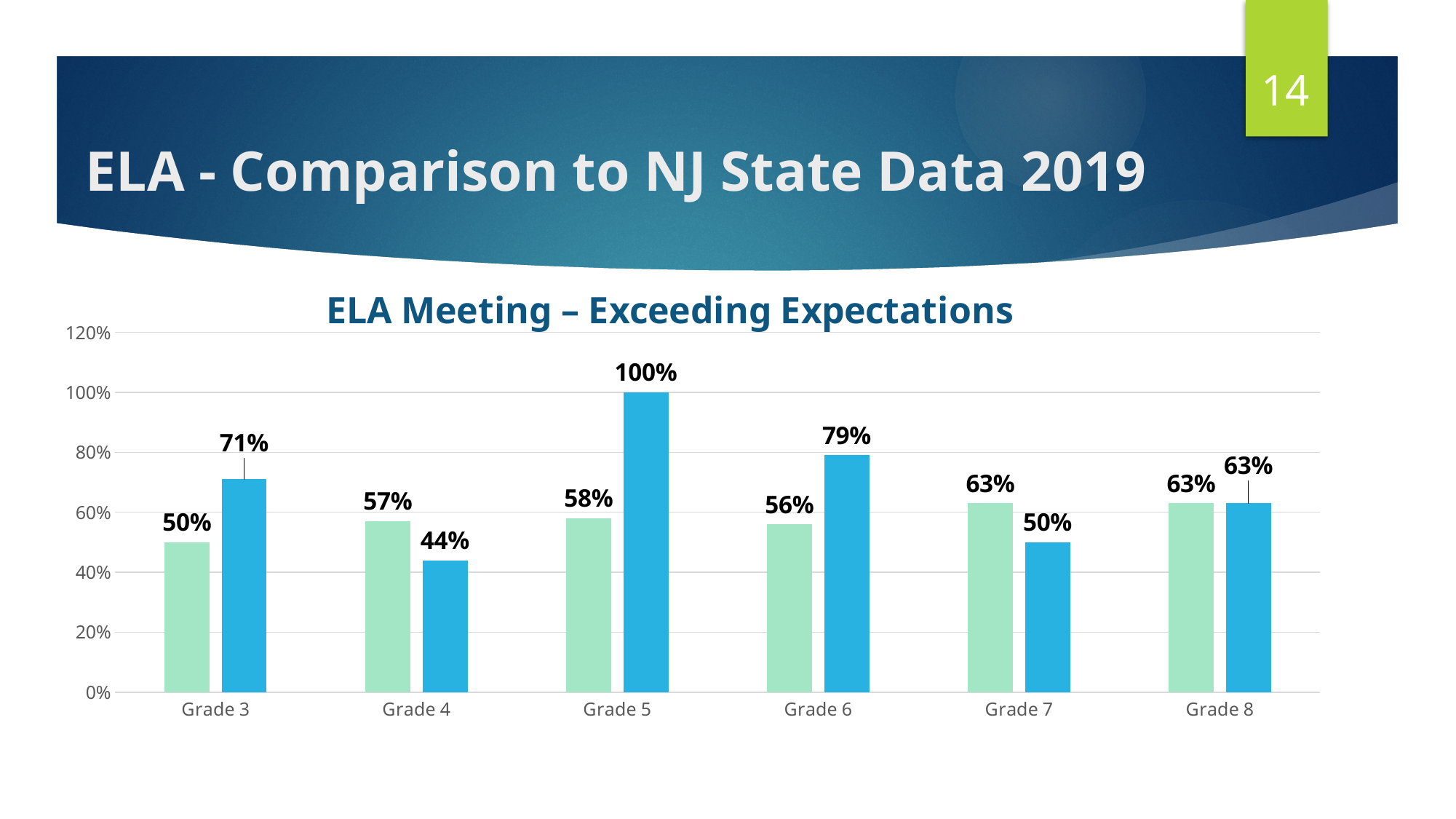
What is the value of the blue bar for Grade 4? 44% What is the difference between the blue bar and the light green bar for Grade 6? 23% How many grades are shown on the x axis? 6 Which grade has the lowest blue bar? Grade 4 For Grade 7, which is larger: the light green bar or the blue bar? the light green bar What is the title of the chart? ELA Meeting – Exceeding Expectations Which grade has the highest blue bar? Grade 5 What is the value of the blue bar for Grade 5? 100% Which grade has the lowest light green bar? Grade 3 What is the value of the light green bar for Grade 3? 50% What is the value of the light green bar for Grade 7? 63% What kind of chart is shown on the slide? bar chart